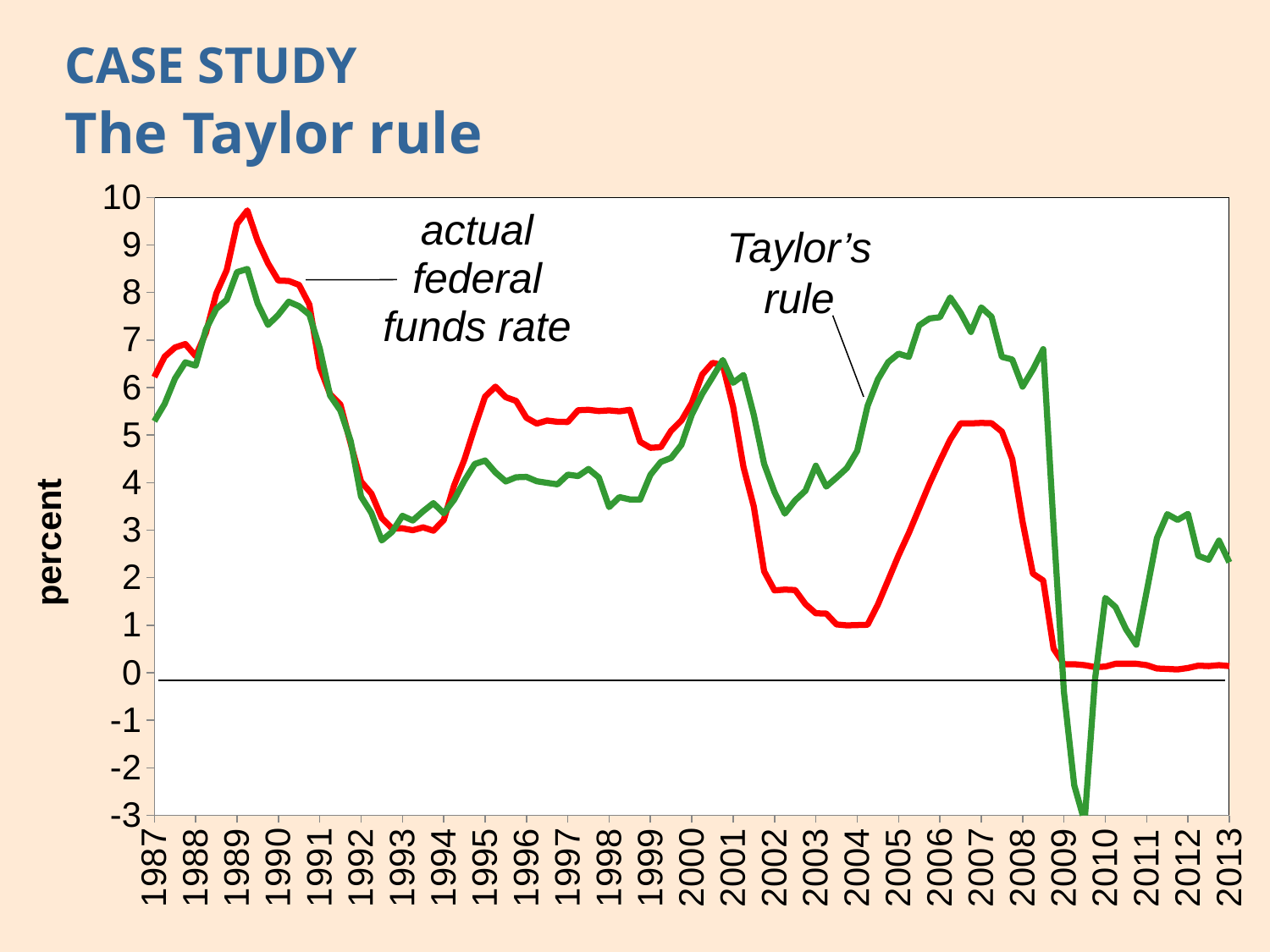
How many data series are plotted on the chart? 2 What is the label on the vertical axis of the chart? percent Is the lowest value reached by the Taylor's rule line greater or less than -2? less Which series reaches the highest value anywhere on the chart? actual federal funds rate In 2006, which is higher: Taylor's rule or the actual federal funds rate? Taylor's rule Is the value of Taylor's rule in 2012 greater or less than 2? greater What kind of chart is shown on the slide? line chart Does the actual federal funds rate rise or fall between 2007 and 2009? fall In 2003, which is higher: Taylor's rule or the actual federal funds rate? Taylor's rule Which series is drawn in red on the chart? actual federal funds rate Is the actual federal funds rate in 2012 greater or less than 1? less